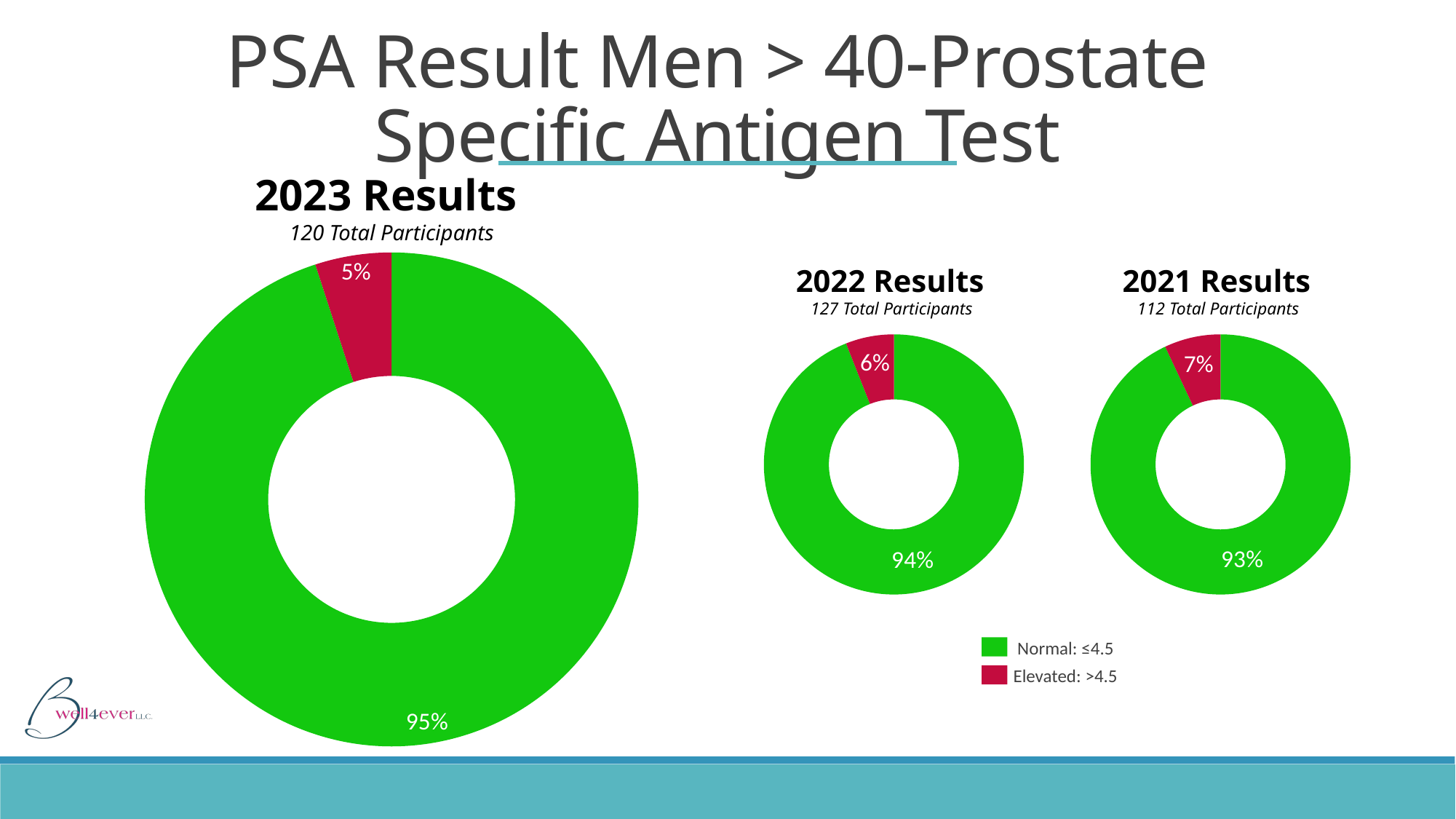
Is the Elevated share larger in the 2022 Results chart or the 2021 Results chart? 2021 Results Which year's chart shows the lowest Elevated percentage? 2023 Results In the 2022 Results chart, what percentage of participants had a Normal PSA result? 94% In the 2023 Results chart, what percentage of participants had an Elevated PSA result? 5% In the 2021 Results chart, what percentage of participants had a Normal PSA result? 93% In the 2021 Results chart, what percentage of participants had an Elevated PSA result? 7% Which year's chart shows the highest Elevated percentage? 2021 Results How many total participants are reported for the 2022 Results chart? 127 What kind of chart is used to show the 2023 Results? Doughnut chart What is the difference between the Normal percentage in the 2023 Results chart and the Normal percentage in the 2021 Results chart? 2% How many categories does the legend list for the charts? 2 In the 2023 Results chart, what percentage of participants had a Normal PSA result? 95%